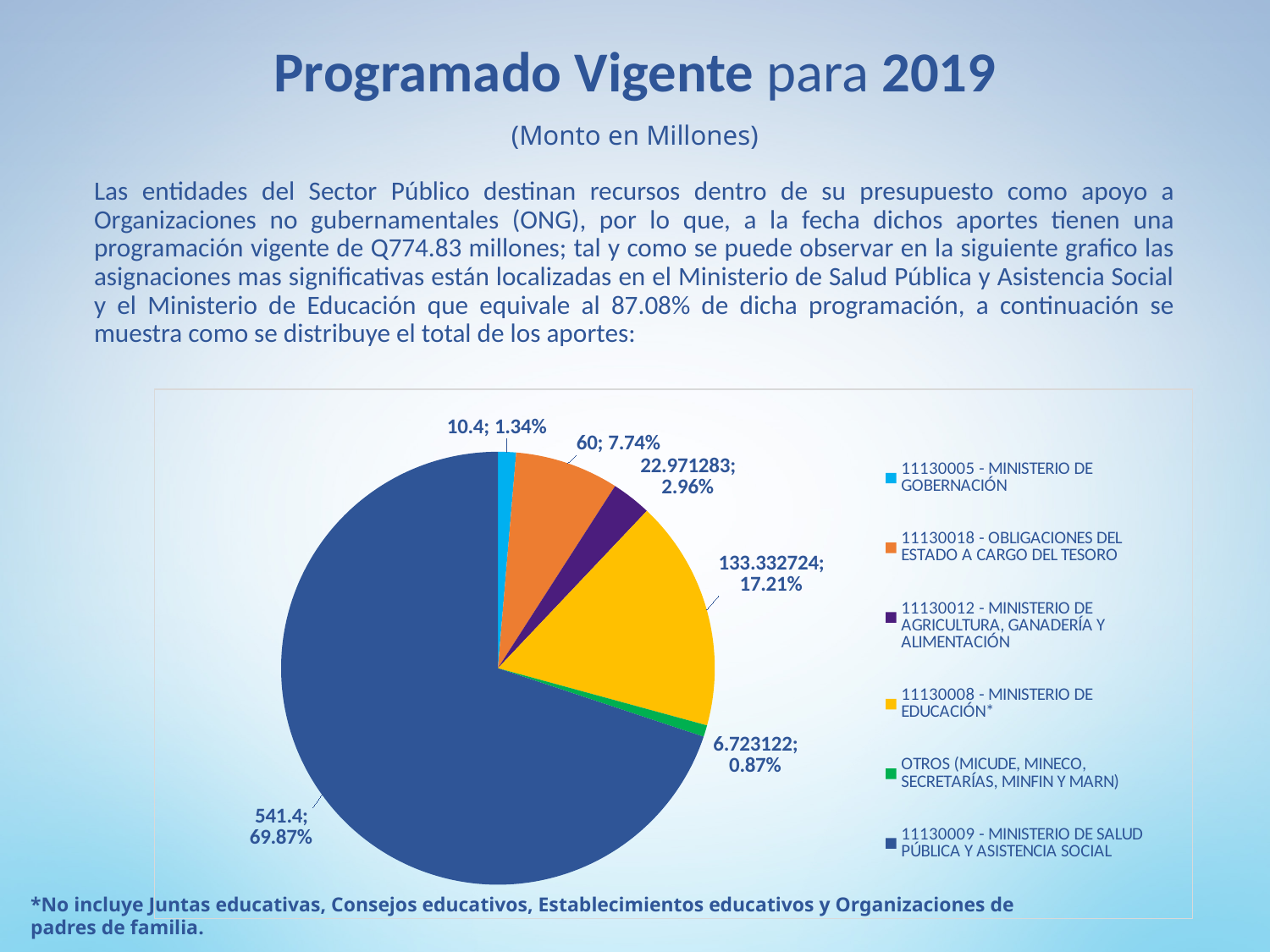
What kind of chart is shown on the slide? pie chart What colour is the slice for 11130008 - MINISTERIO DE EDUCACIÓN* in the pie chart? yellow What value is shown for 11130012 - MINISTERIO DE AGRICULTURA, GANADERÍA Y ALIMENTACIÓN? 22.971283 Which is larger: the value for 11130018 - OBLIGACIONES DEL ESTADO A CARGO DEL TESORO or the value for 11130012 - MINISTERIO DE AGRICULTURA, GANADERÍA Y ALIMENTACIÓN? 11130018 - OBLIGACIONES DEL ESTADO A CARGO DEL TESORO What percentage share does 11130005 - MINISTERIO DE GOBERNACIÓN have in the pie chart? 1.34% What value is shown for 11130018 - OBLIGACIONES DEL ESTADO A CARGO DEL TESORO? 60 How many slices does the pie chart have? 6 Which category has the smallest slice in the pie chart? OTROS (MICUDE, MINECO, SECRETARÍAS, MINFIN Y MARN) How many entries does the legend of the pie chart list? 6 What value is shown for 11130009 - MINISTERIO DE SALUD PÚBLICA Y ASISTENCIA SOCIAL? 541.4 Which category has the largest slice in the pie chart? 11130009 - MINISTERIO DE SALUD PÚBLICA Y ASISTENCIA SOCIAL What percentage share does 11130008 - MINISTERIO DE EDUCACIÓN* have in the pie chart? 17.21%